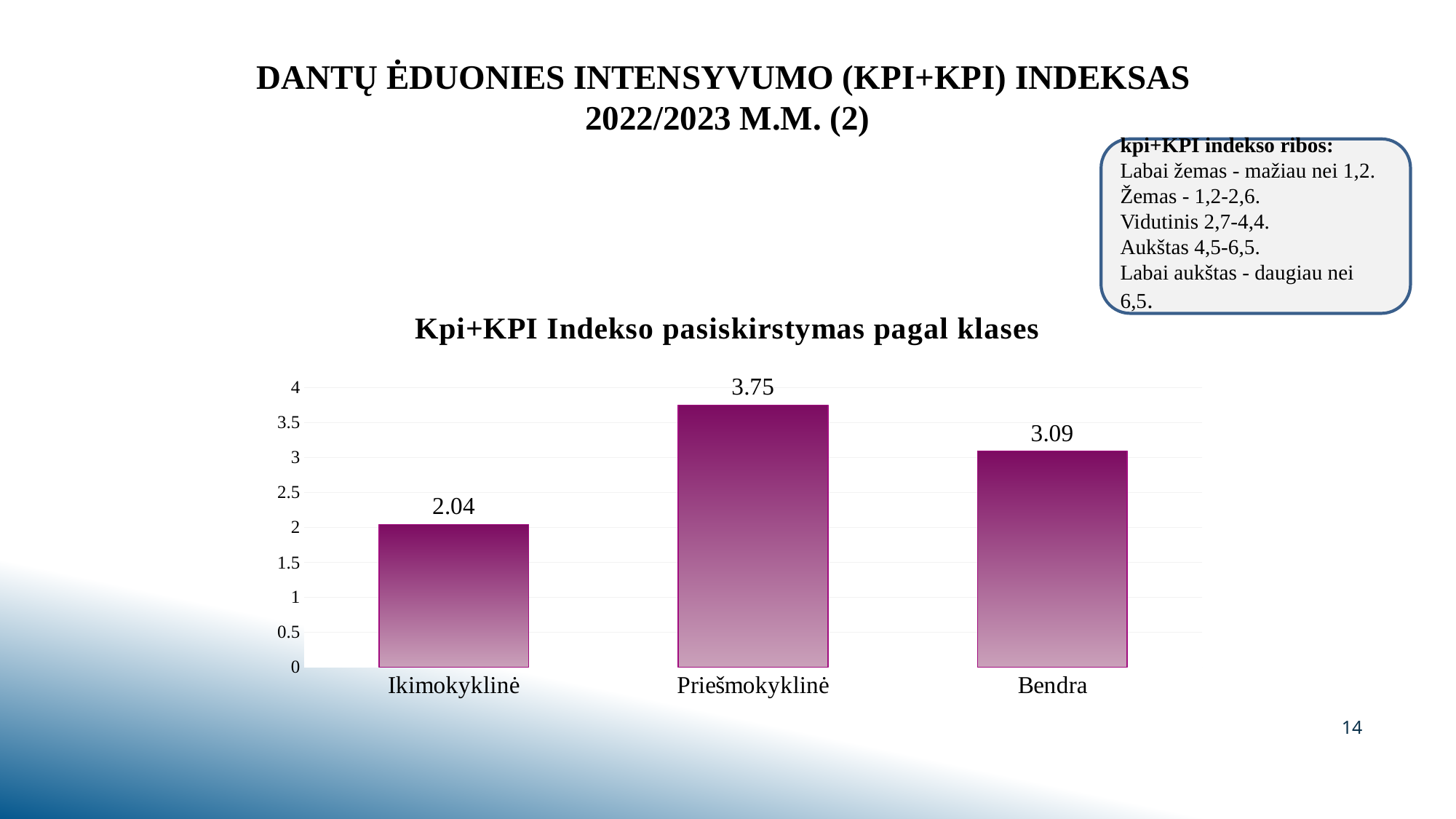
How many categories are shown on the x axis? 3 What is the value for Ikimokyklinė? 2.04 Which category has the highest value? Priešmokyklinė Is the value for Priešmokyklinė greater or less than 3.5? greater What kind of chart is shown on the slide? bar chart What is the title of the chart? Kpi+KPI Indekso pasiskirstymas pagal klases Which category has the lowest value? Ikimokyklinė Which is larger, the value for Bendra or the value for Ikimokyklinė? Bendra What is the value for Bendra? 3.09 What is the difference between the values for Priešmokyklinė and Bendra? 0.66 What is the difference between the values for Priešmokyklinė and Ikimokyklinė? 1.71 What is the value for Priešmokyklinė? 3.75